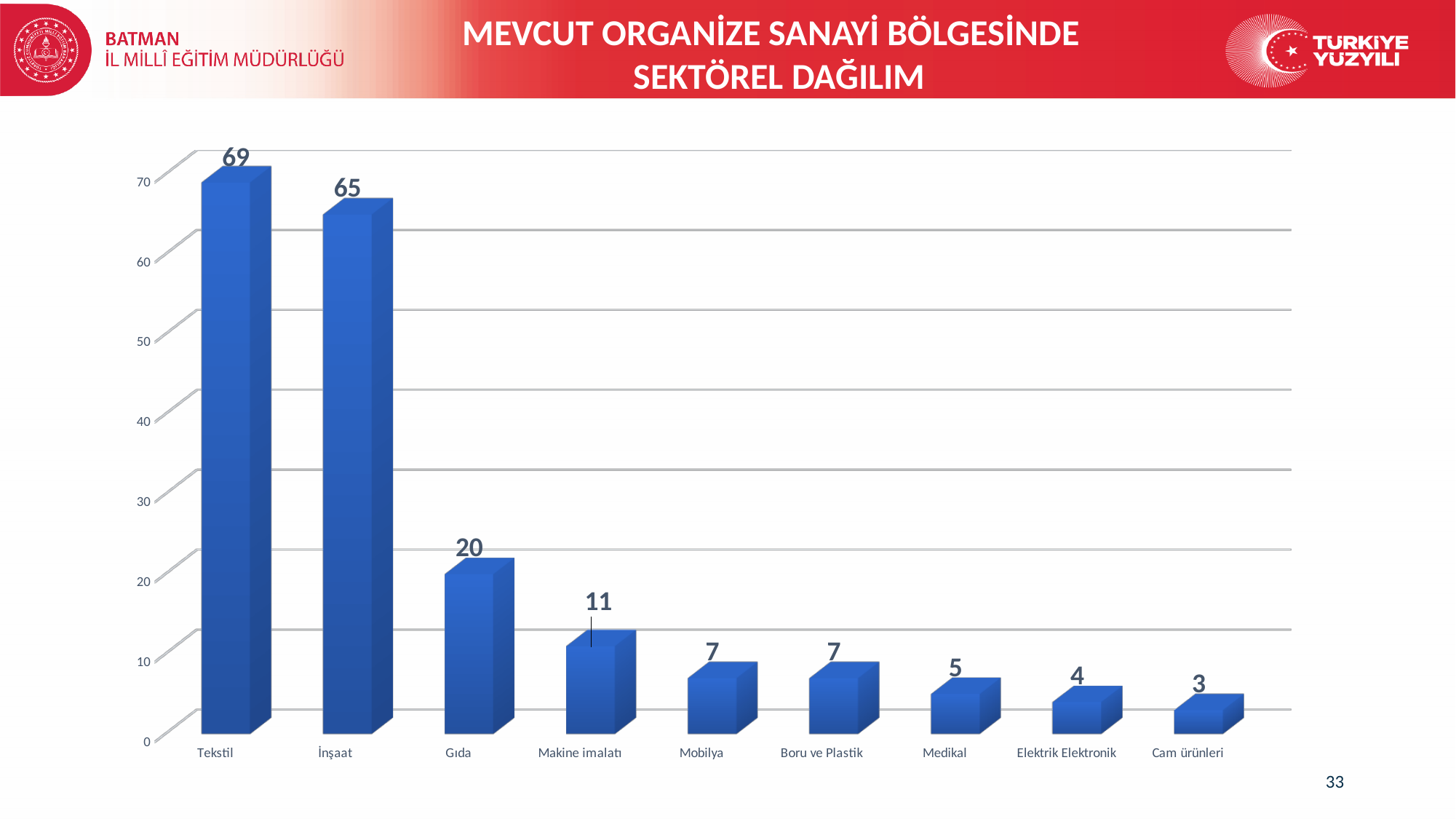
Which is larger, the value for İnşaat or the value for Gıda? İnşaat Which category has the highest value? Tekstil What is the difference between the values for Tekstil and İnşaat? 4 What is the value for Gıda? 20 Which category has the lowest value? Cam ürünleri What is the difference between the values for Gıda and Medikal? 15 What kind of chart is shown on the slide? Bar chart What is the title of the slide? MEVCUT ORGANİZE SANAYİ BÖLGESİNDE SEKTÖREL DAĞILIM What is the value for Makine imalatı? 11 What is the value for Tekstil? 69 How many categories are shown on the x axis? 9 What is the value for Elektrik Elektronik? 4